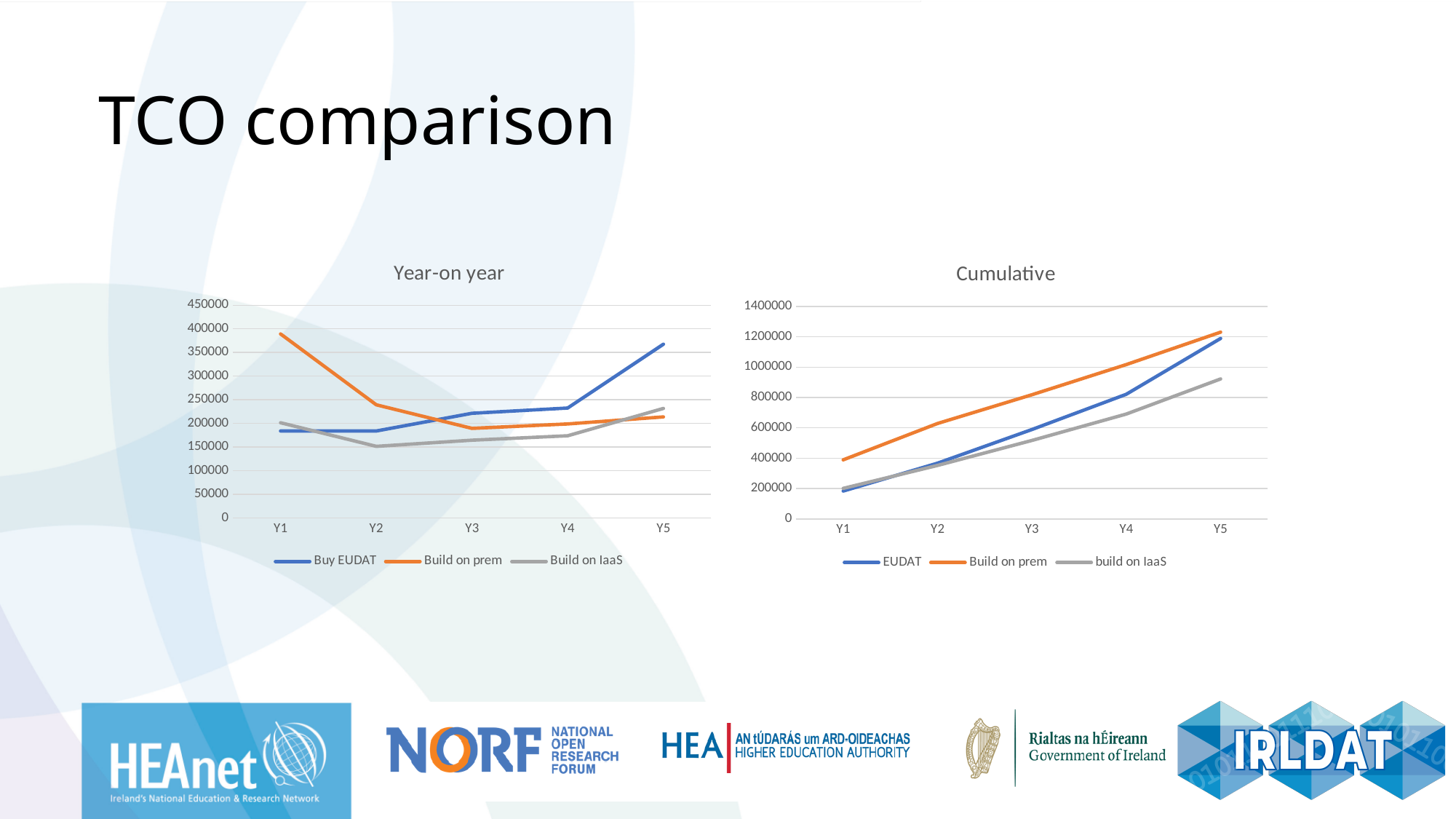
In the "Year-on year" chart, which series has the highest value at Y5? Buy EUDAT In the "Cumulative" chart, is the value for build on IaaS at Y5 greater or less than 1000000? less In the "Cumulative" chart, is the value for Build on prem at Y1 greater or less than 300000? greater In the "Year-on year" chart, is the value for Build on prem at Y1 greater or less than 350000? greater How many points are on the x axis of the "Cumulative" chart? 5 In the "Cumulative" chart, which series has the lowest value at Y5? build on IaaS What kind of chart is the "Year-on year" chart? line chart What colour is the Build on prem line in the "Cumulative" chart? orange How many series does the legend of the "Year-on year" chart list? 3 In the "Cumulative" chart, does the EUDAT line rise or fall from Y1 to Y5? rises In the "Year-on year" chart, which series has the highest value at Y1? Build on prem